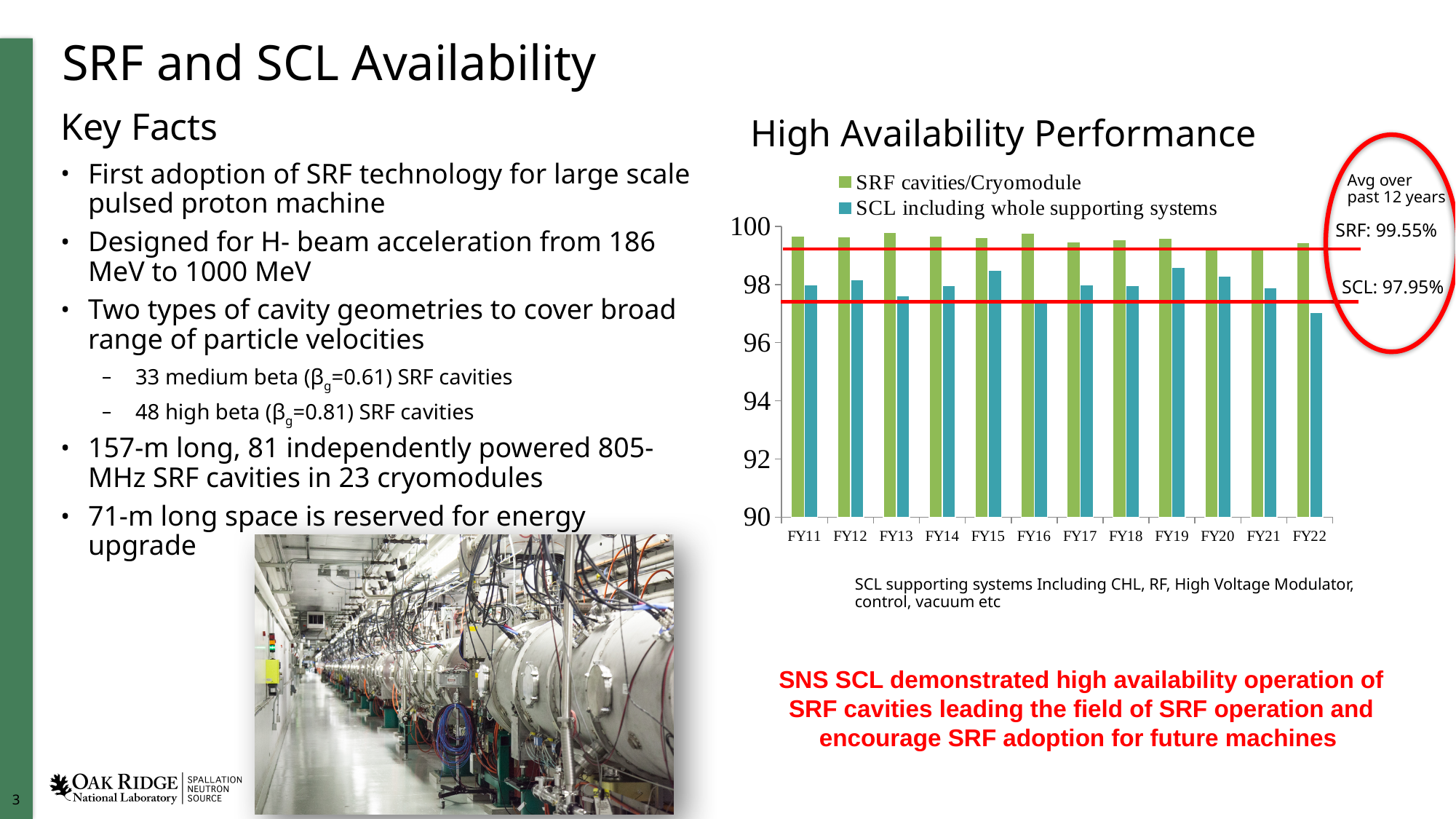
In the 'High Availability Performance' chart, which fiscal year has the lowest value for SCL including whole supporting systems? FY22 What kind of chart is shown under the title 'High Availability Performance'? bar chart In the 'High Availability Performance' chart, which is larger in FY16: SRF cavities/Cryomodule or SCL including whole supporting systems? SRF cavities/Cryomodule In the 'High Availability Performance' chart, is the value for SCL including whole supporting systems in FY13 greater or less than 96? greater Which series in the 'High Availability Performance' chart is shown in green? SRF cavities/Cryomodule According to the annotation on the 'High Availability Performance' chart, what is the SCL average availability over the past 12 years? 97.95% What is the title of the chart on the slide? High Availability Performance In the 'High Availability Performance' chart, is the value for SRF cavities/Cryomodule in FY11 greater or less than 98? greater How many series does the legend of the 'High Availability Performance' chart list? 2 How many fiscal years are shown on the x axis of the 'High Availability Performance' chart? 12 In the 'High Availability Performance' chart, is the value for SCL including whole supporting systems in FY22 greater or less than 98? less According to the annotation on the 'High Availability Performance' chart, what is the SRF average availability over the past 12 years? 99.55%